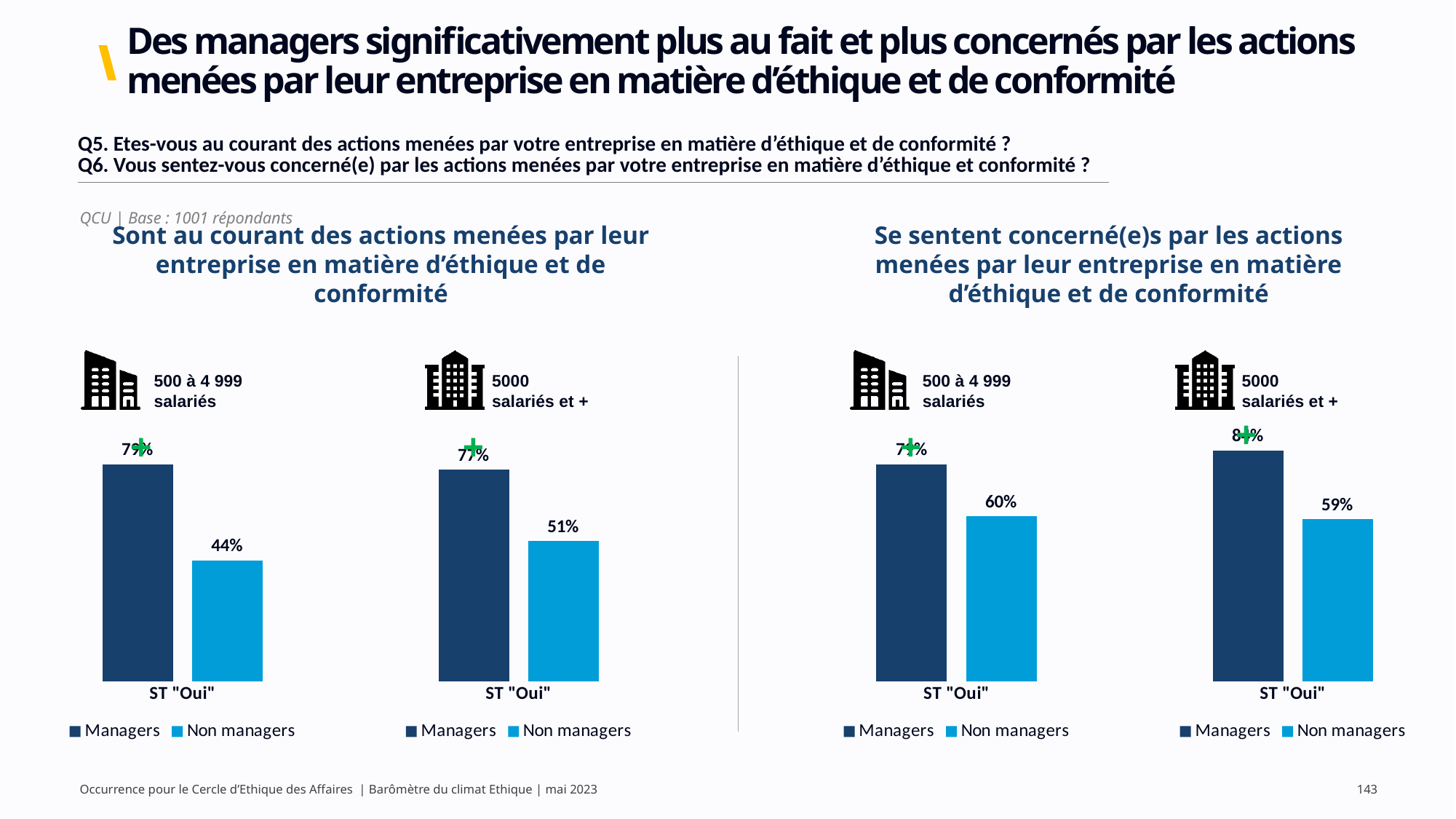
In the chart for '500 à 4 999 salariés' under 'Se sentent concerné(e)s par les actions menées', what is the value for Non managers? 60% What is the category label shown on the x axis of each chart? ST "Oui" In the chart for '5000 salariés et +' under 'Sont au courant des actions menées par leur entreprise', what is the value for Non managers? 51% How many series does the legend of each chart list? 2 Under 'Sont au courant des actions menées par leur entreprise', is the Non managers value higher for '500 à 4 999 salariés' or for '5000 salariés et +'? 5000 salariés et + In the chart for '5000 salariés et +' under 'Se sentent concerné(e)s par les actions menées', what is the value for Non managers? 59% What are the two legend entries shown under each chart? Managers and Non managers In the chart for '5000 salariés et +' under 'Sont au courant des actions menées par leur entreprise', what is the difference between Managers and Non managers? 26 percentage points In the chart for '500 à 4 999 salariés' under 'Sont au courant des actions menées par leur entreprise', what is the value for Non managers? 44% What kind of chart is used on this slide? Bar chart In the chart for '5000 salariés et +' under 'Sont au courant des actions menées par leur entreprise', what is the value for Managers? 77% In the chart for '500 à 4 999 salariés' under 'Se sentent concerné(e)s par les actions menées', which series has the higher value, Managers or Non managers? Managers